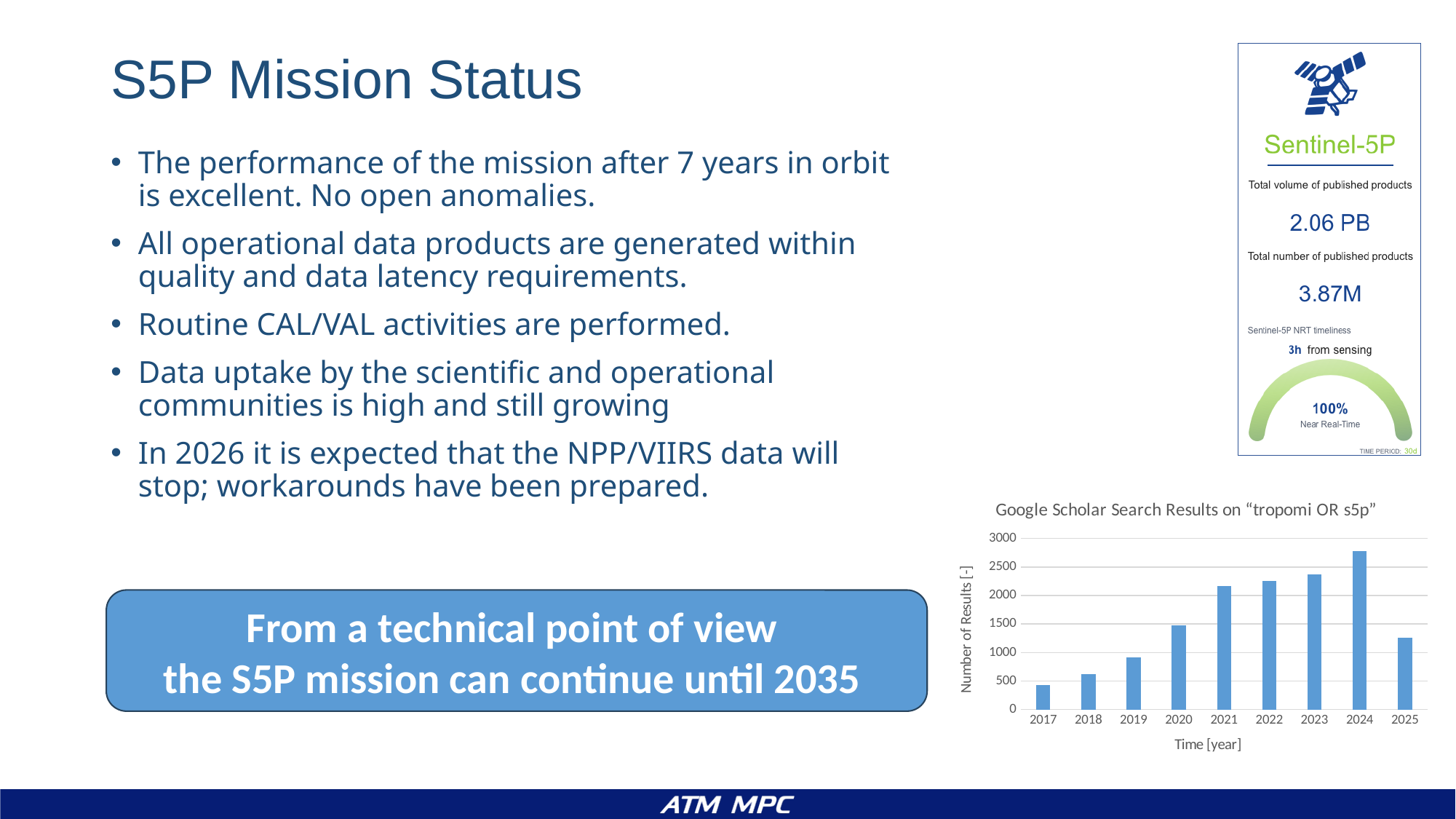
Which year has the highest number of results in the Google Scholar Search Results chart? 2024 How many years are shown on the x axis of the Google Scholar Search Results chart? 9 In the Google Scholar Search Results chart, is the value for 2021 greater or less than 2000? greater In the Google Scholar Search Results chart, is the value for 2019 greater or less than 1000? less In the Google Scholar Search Results chart, which year has more results, 2024 or 2025? 2024 In the Google Scholar Search Results chart, is the value for 2017 greater or less than 500? less In the Google Scholar Search Results chart, do the values rise or fall from 2017 to 2024? rise In the Google Scholar Search Results chart, which year has more results, 2019 or 2020? 2020 Which year has the lowest number of results in the Google Scholar Search Results chart? 2017 What kind of chart is the Google Scholar Search Results chart? bar chart What is the label of the y axis of the Google Scholar Search Results chart? Number of Results [-]